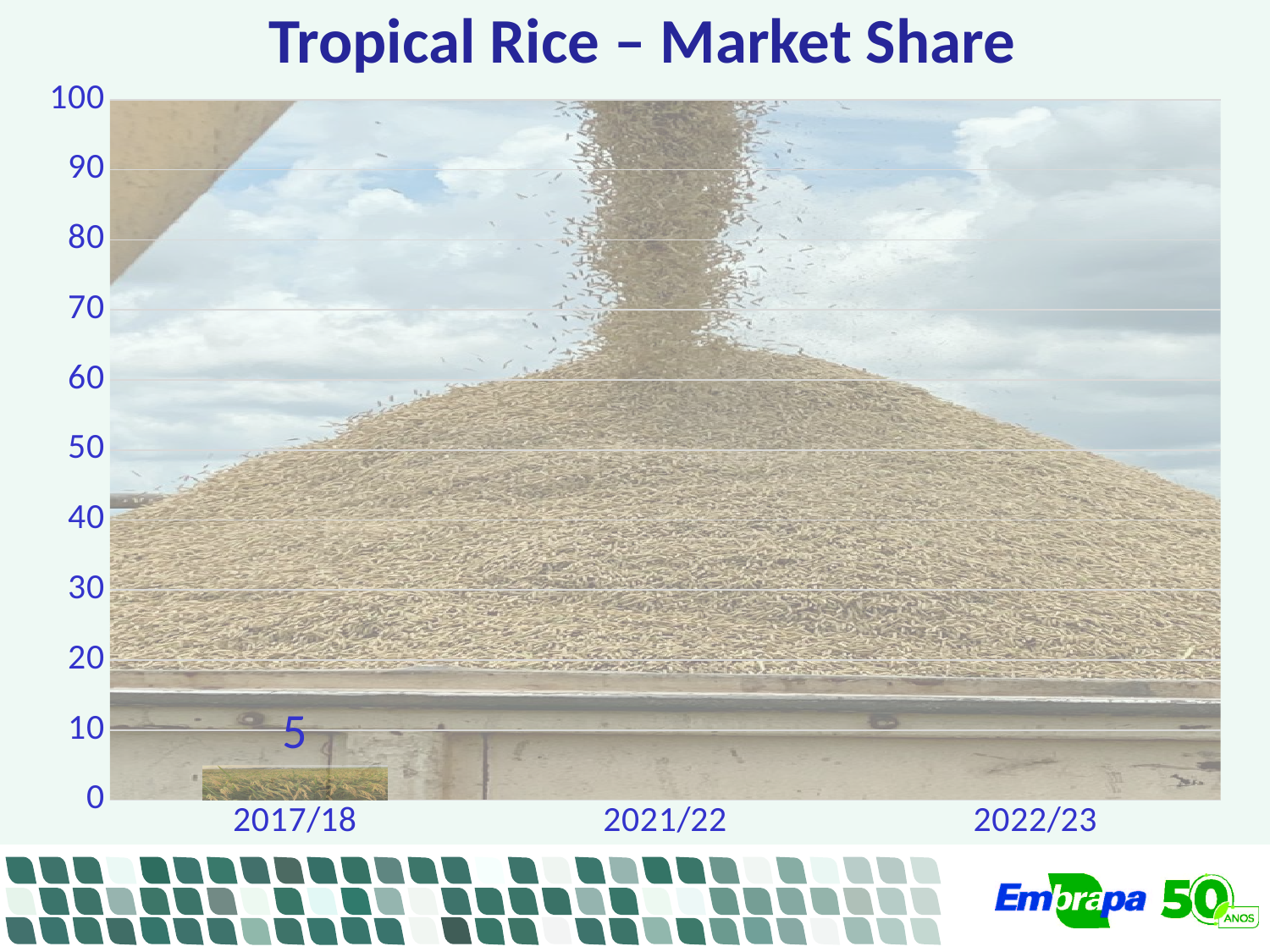
What is the title of the chart? Tropical Rice – Market Share What kind of chart is this? bar chart Is the value for 2017/18 greater or less than 10? less How many categories are shown on the x axis? 3 What is the value shown for 2017/18? 5 What is the highest value shown on the y axis? 100